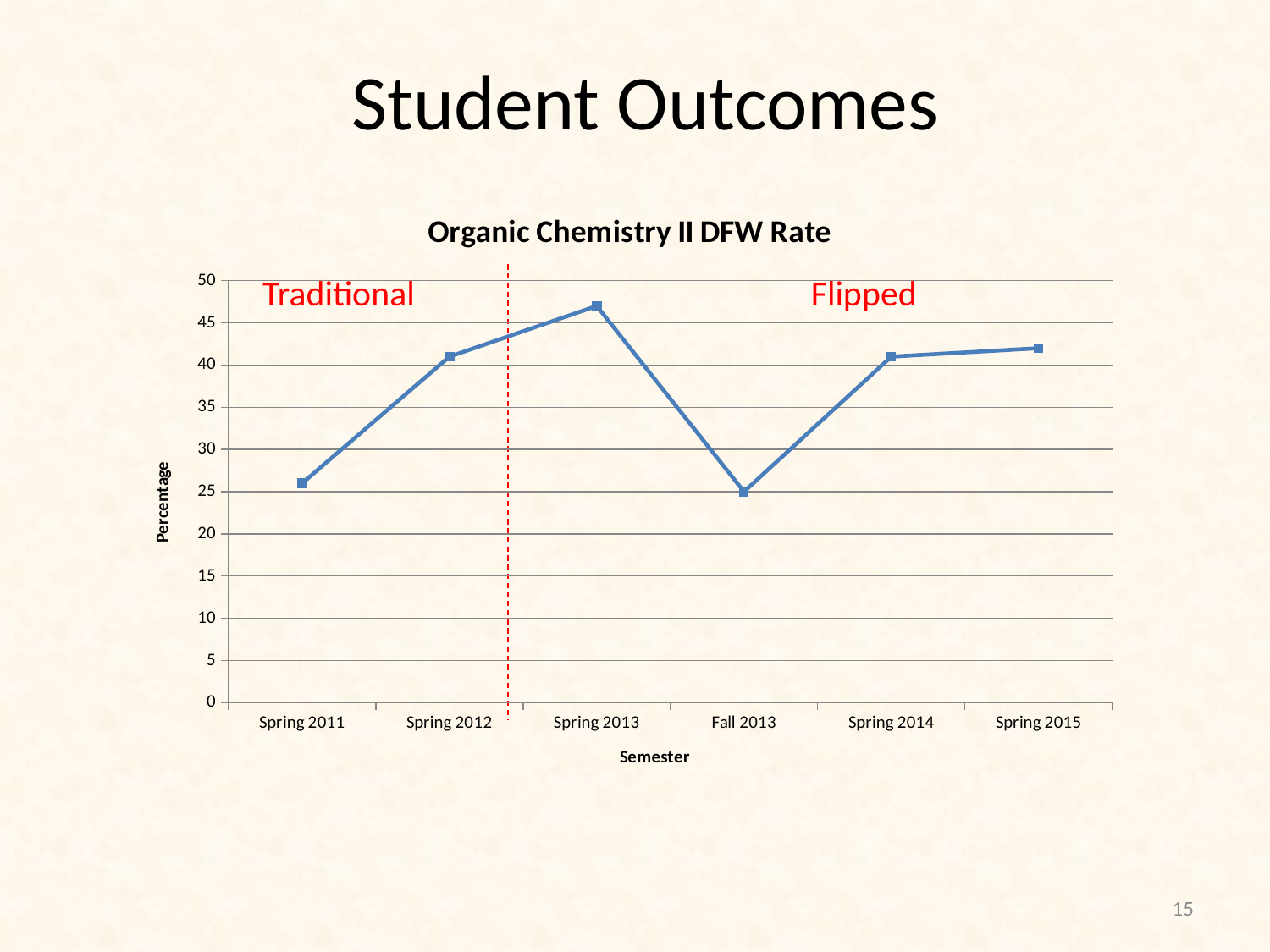
Is the DFW rate for Spring 2011 greater or less than 30? less Which has a higher DFW rate, Spring 2013 or Fall 2013? Spring 2013 What kind of chart is shown on the slide? line chart Does the DFW rate rise or fall from Spring 2011 to Spring 2013? rise Is the DFW rate for Fall 2013 greater or less than 30? less How many semesters are plotted on the x axis? 6 Is the DFW rate for Spring 2013 greater or less than 45? greater Which semester has the highest DFW rate? Spring 2013 What label is shown on the right side of the dashed red line, above the later semesters? Flipped What is the title of the chart? Organic Chemistry II DFW Rate Which has a higher DFW rate, Spring 2011 or Spring 2012? Spring 2012